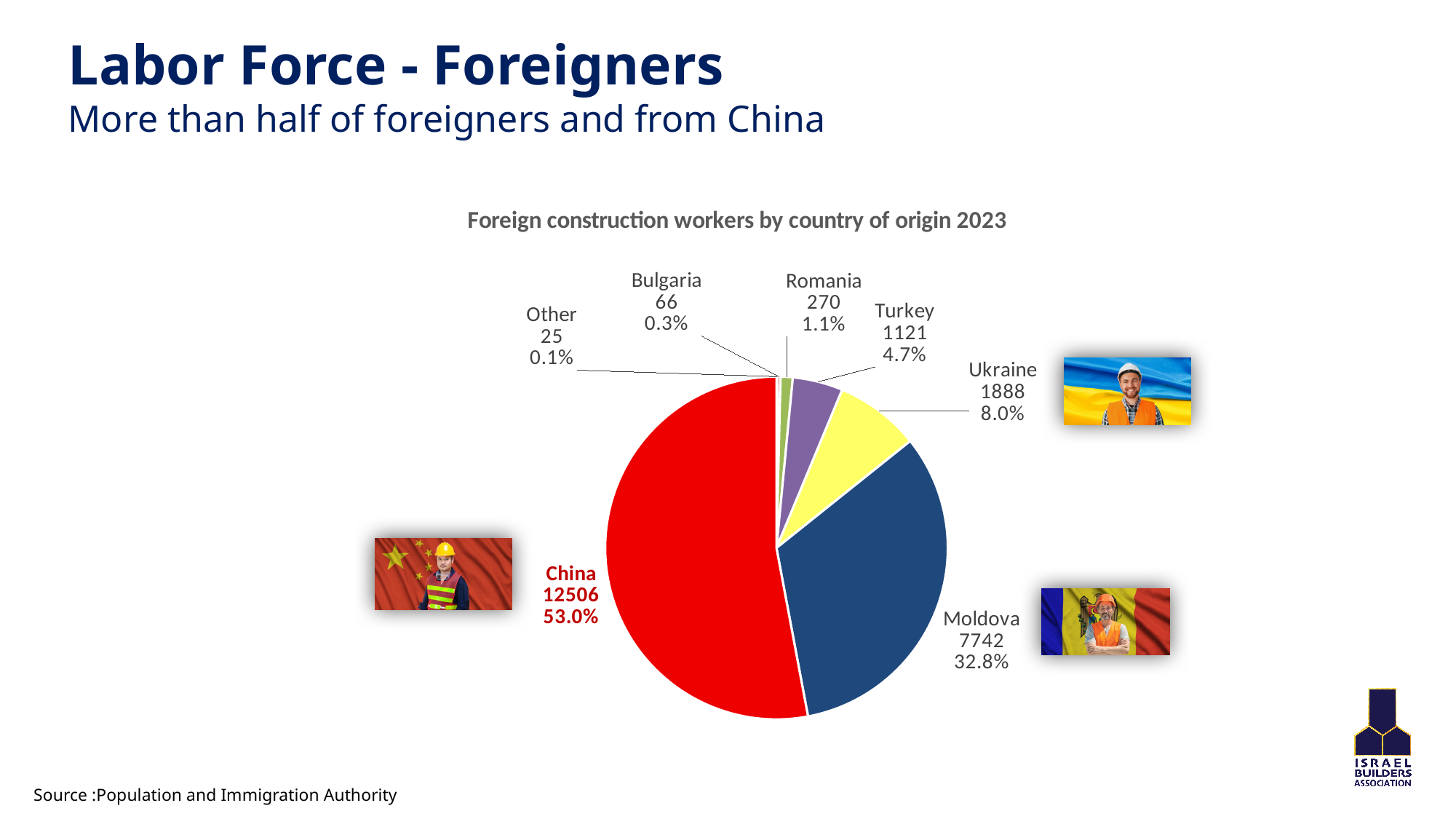
Which has more workers, Romania or Bulgaria? Romania What type of chart is shown on the slide? Pie chart How many workers came from Turkey? 1121 What is the difference between the number of workers from China and from Moldova? 4764 What is the title of the chart? Foreign construction workers by country of origin 2023 What colour is the slice for Moldova? Dark blue Which country has the largest slice of the pie? China What percentage share does China have? 53.0% What share of the pie does Ukraine represent? 8.0% How many categories are shown in the pie chart? 7 How many foreign construction workers came from Moldova? 7742 Which category has the smallest slice of the pie? Other